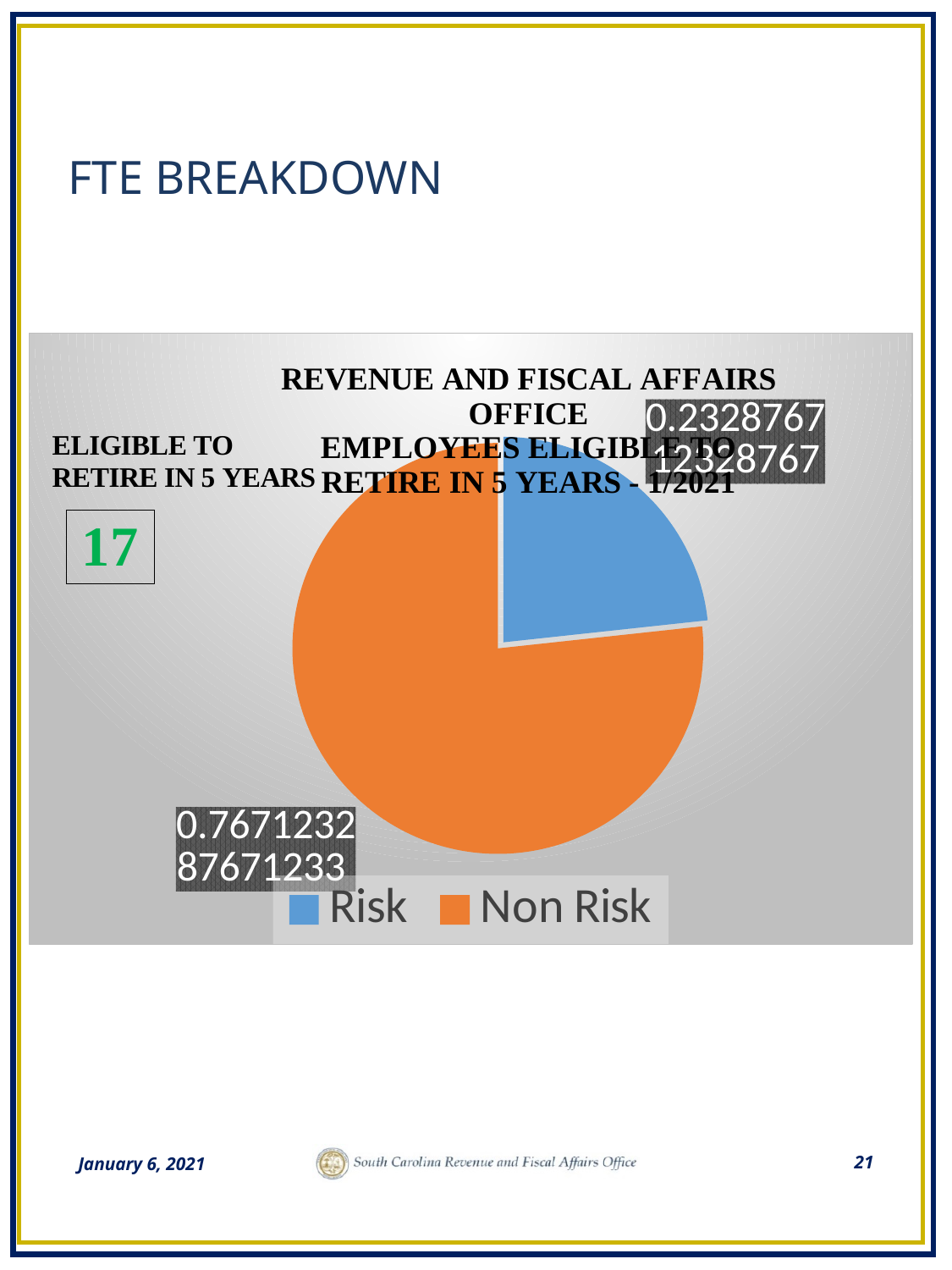
How many entries does the legend of the pie chart list? 2 Which slice of the pie chart is the largest? Non Risk Which slice of the pie chart is the smallest? Risk How many slices does the pie chart have? 2 What is the difference between the Non Risk value and the Risk value in the pie chart? 0.534246575342466 What value is labelled on the Non Risk slice of the pie chart? 0.767123287671233 What value is labelled on the Risk slice of the pie chart? 0.232876712328767 What is the title of the pie chart? REVENUE AND FISCAL AFFAIRS OFFICE EMPLOYEES ELIGIBLE TO RETIRE IN 5 YEARS - 1/2021 Which is larger in the pie chart, Risk or Non Risk? Non Risk What share of the pie does the Risk slice represent? 0.232876712328767 What colour is the Non Risk slice in the pie chart? Orange What kind of chart is shown on the slide? Pie chart